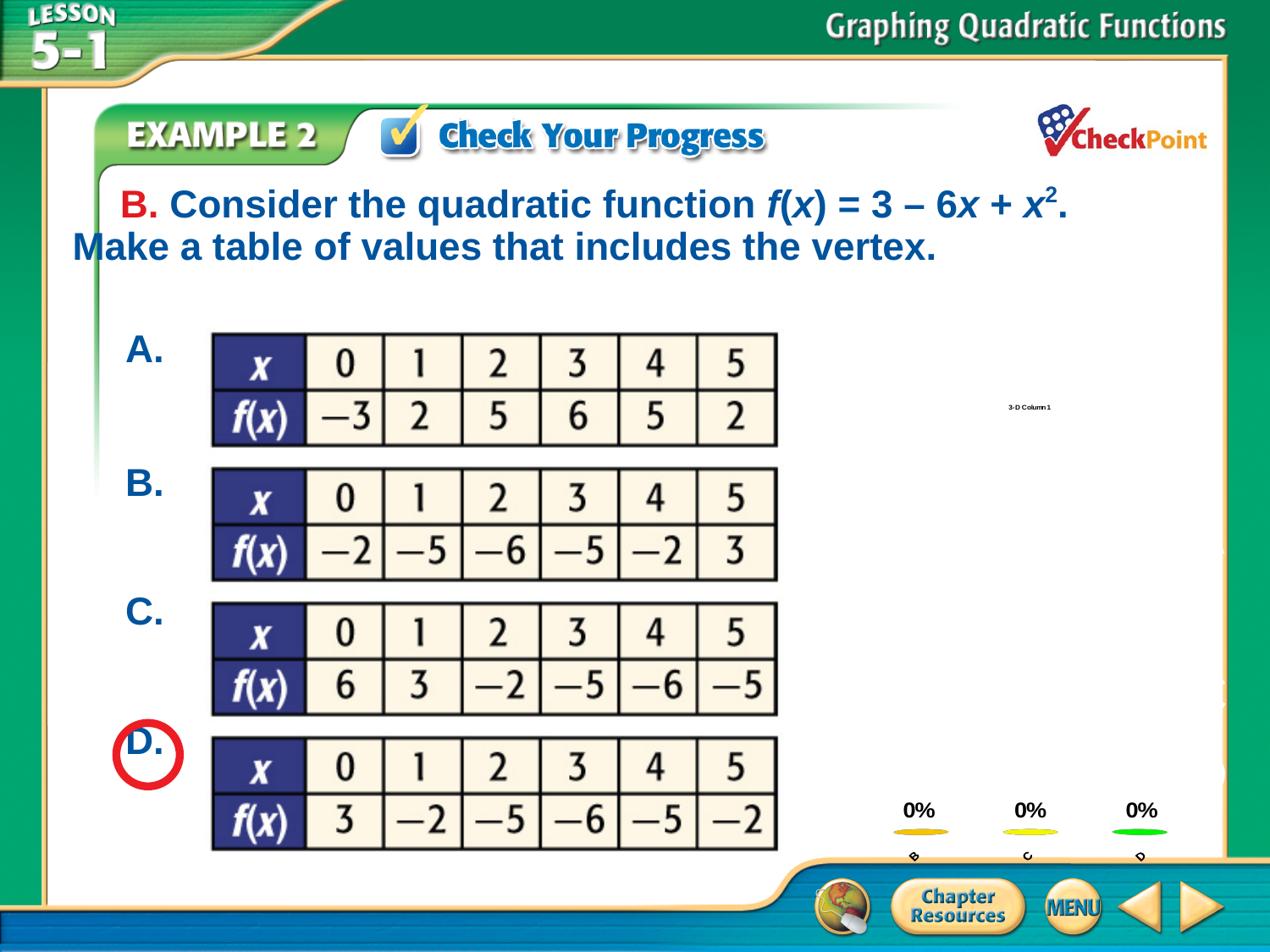
What colour is the middle bar in the chart at the bottom right of the slide? yellow How many bars (data points) are shown in the chart at the bottom right of the slide? 3 What value is printed above the middle bar in the chart at the bottom right of the slide? 0% In the chart at the bottom right of the slide, what is the difference between the value of the first bar and the value of the last bar? 0% What value is printed above the first bar in the chart at the bottom right of the slide? 0% In the chart at the bottom right of the slide, do the values rise, fall, or stay the same from left to right? stay the same What value is printed above the last bar in the chart at the bottom right of the slide? 0% What kind of chart is shown at the bottom right of the slide? bar chart What is the title of the chart at the bottom right of the slide? 3-D Column 1